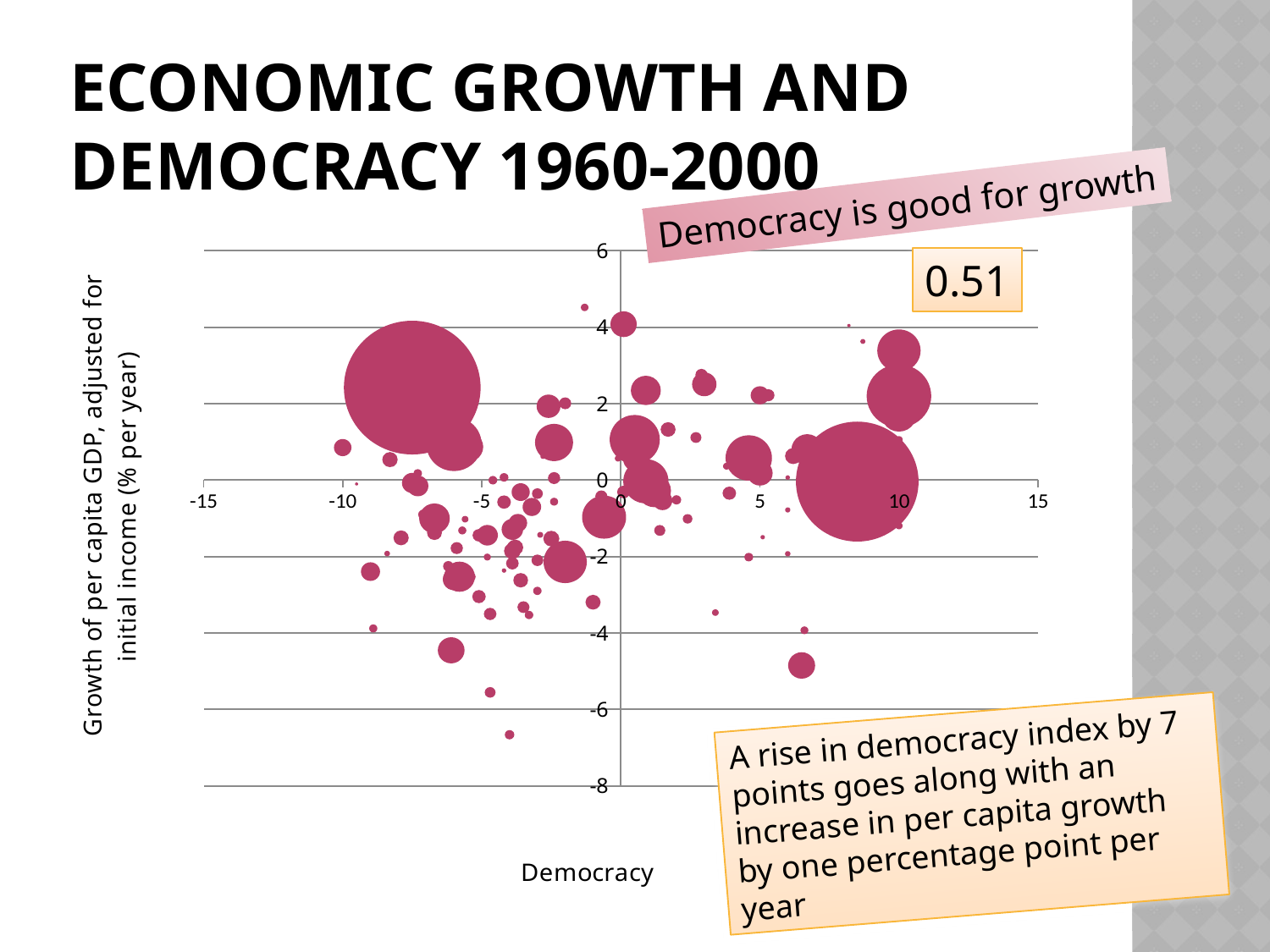
Is the growth value of the highest bubble on the chart greater or less than 4? greater Is the democracy value of the large bubble near the 10 tick on the x axis greater or less than 5? greater Is the growth value of the lowest bubble on the chart greater or less than -6? less What kind of chart is shown on the slide? bubble chart What number is shown in the highlighted box at the top right of the chart? 0.51 Do the growth values generally rise or fall as the democracy index increases along the x axis? rise What is the label of the x axis of the chart? Democracy